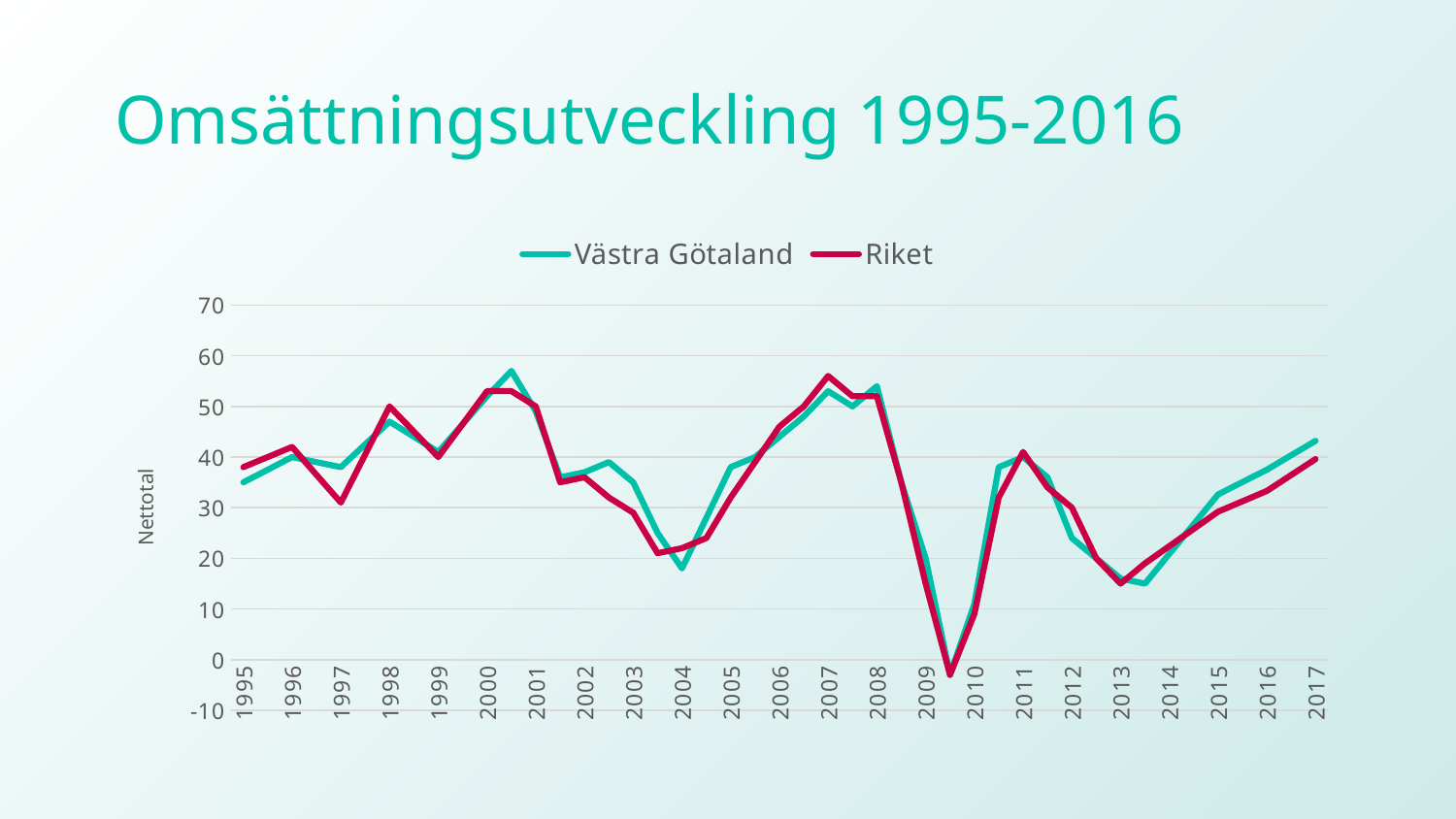
Is the value for Riket in 1997 greater or less than 40? less Is the value for Västra Götaland in 2017 greater or less than 40? greater Is the value for Riket in 2013 greater or less than 20? less How many series does the legend list? 2 Which series has the higher value in 2012, Västra Götaland or Riket? Riket Do the values for both series rise or fall between 2013 and 2017? rise Which series has the higher value in 1997, Västra Götaland or Riket? Västra Götaland What is the label on the vertical axis? Nettotal Do the values for both series rise or fall between 2008 and 2009? fall What kind of chart is shown on the slide? line chart What is the title of the chart? Omsättningsutveckling 1995-2016